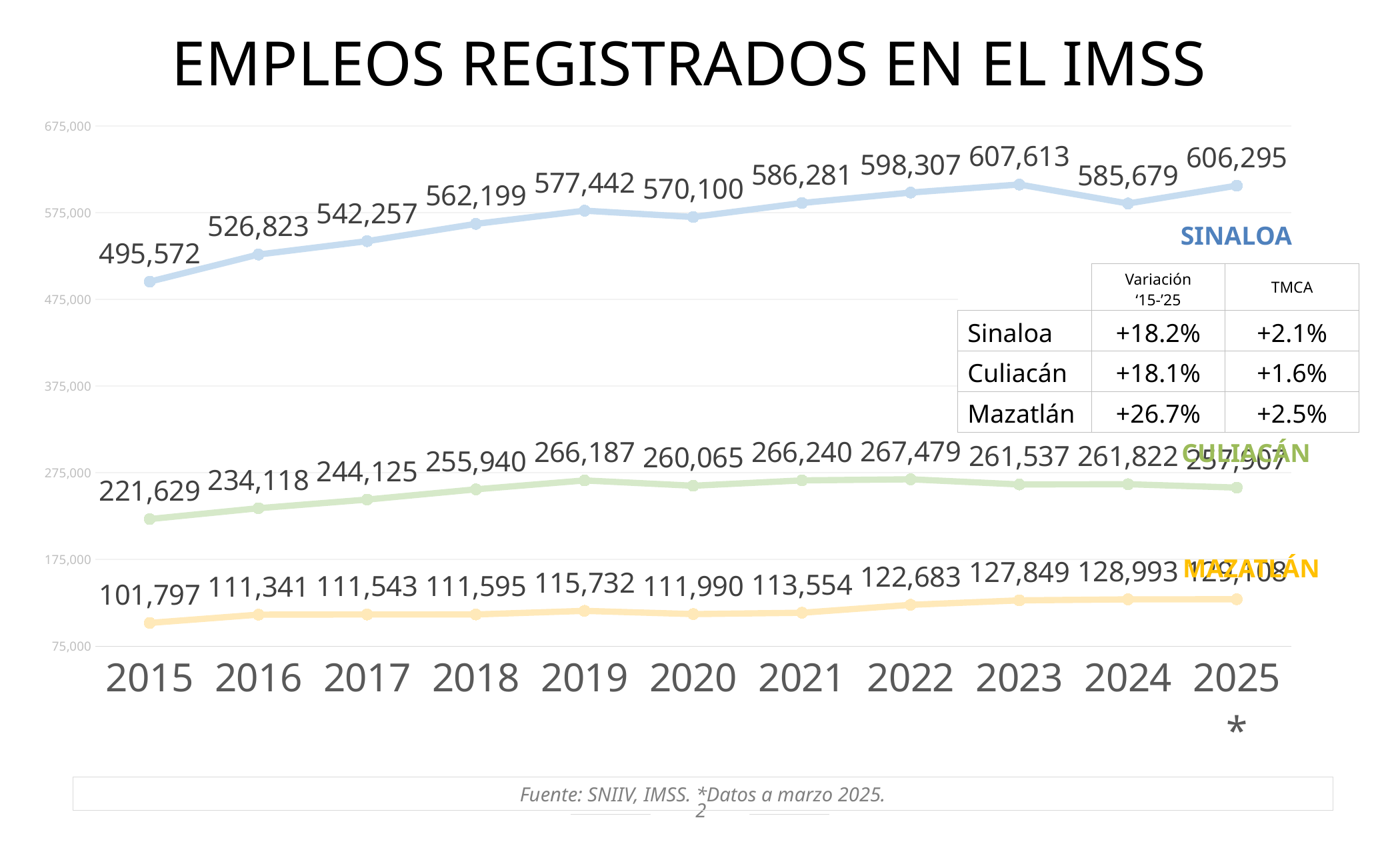
Which year had the larger Culiacán value, 2021 or 2022? 2022 What is the difference between the Mazatlán values for 2022 and 2021? 9,129 How many series (lines) are plotted on the chart? 3 What type of chart is shown on the slide? Line chart In which year did Sinaloa reach its highest value on the chart? 2023 What value is shown for Mazatlán in 2023? 127,849 What value is shown for Culiacán in 2019? 266,187 Did the Sinaloa values rise or fall from 2015 to 2019? Rise How many years are shown on the x axis of the chart? 11 In which year was the Mazatlán value lowest? 2015 What was the number of IMSS-registered jobs in Sinaloa in 2015? 495,572 By how much did the Sinaloa value increase from 2015 to 2016? 31,251